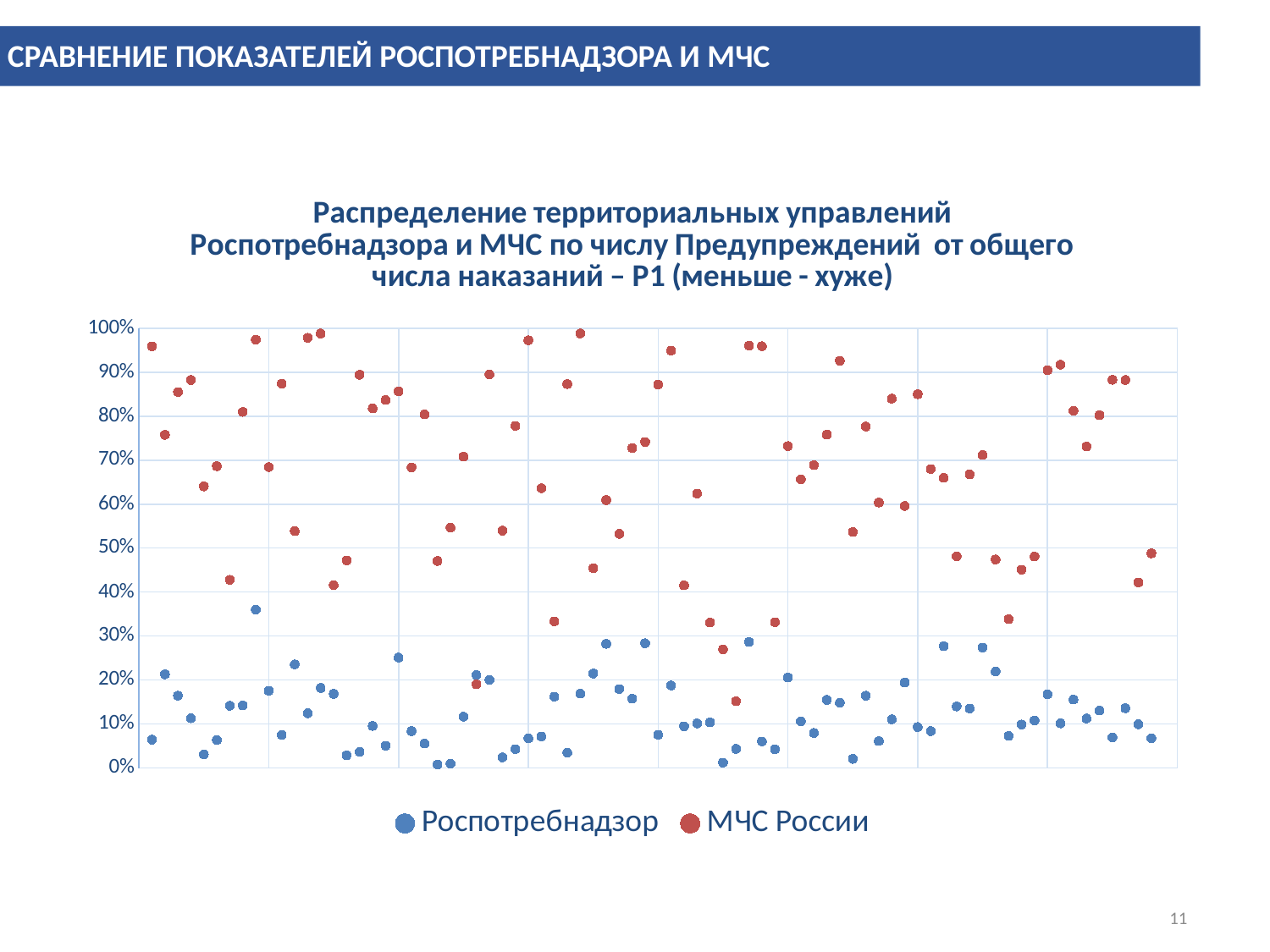
Which series contains the lowest point on the chart? Роспотребнадзор Is the highest value for МЧС России greater or less than 90%? greater Is the lowest value for МЧС России greater or less than 10%? greater How many series does the chart legend list? 2 What kind of chart is shown on the slide? Scatter chart What colour are the points for the Роспотребнадзор series? Blue Is the highest value for Роспотребнадзор greater or less than 40%? less Which series contains the highest point on the chart? МЧС России What are the two series named in the chart legend? Роспотребнадзор and МЧС России Which series generally has higher values on the chart, Роспотребнадзор or МЧС России? МЧС России